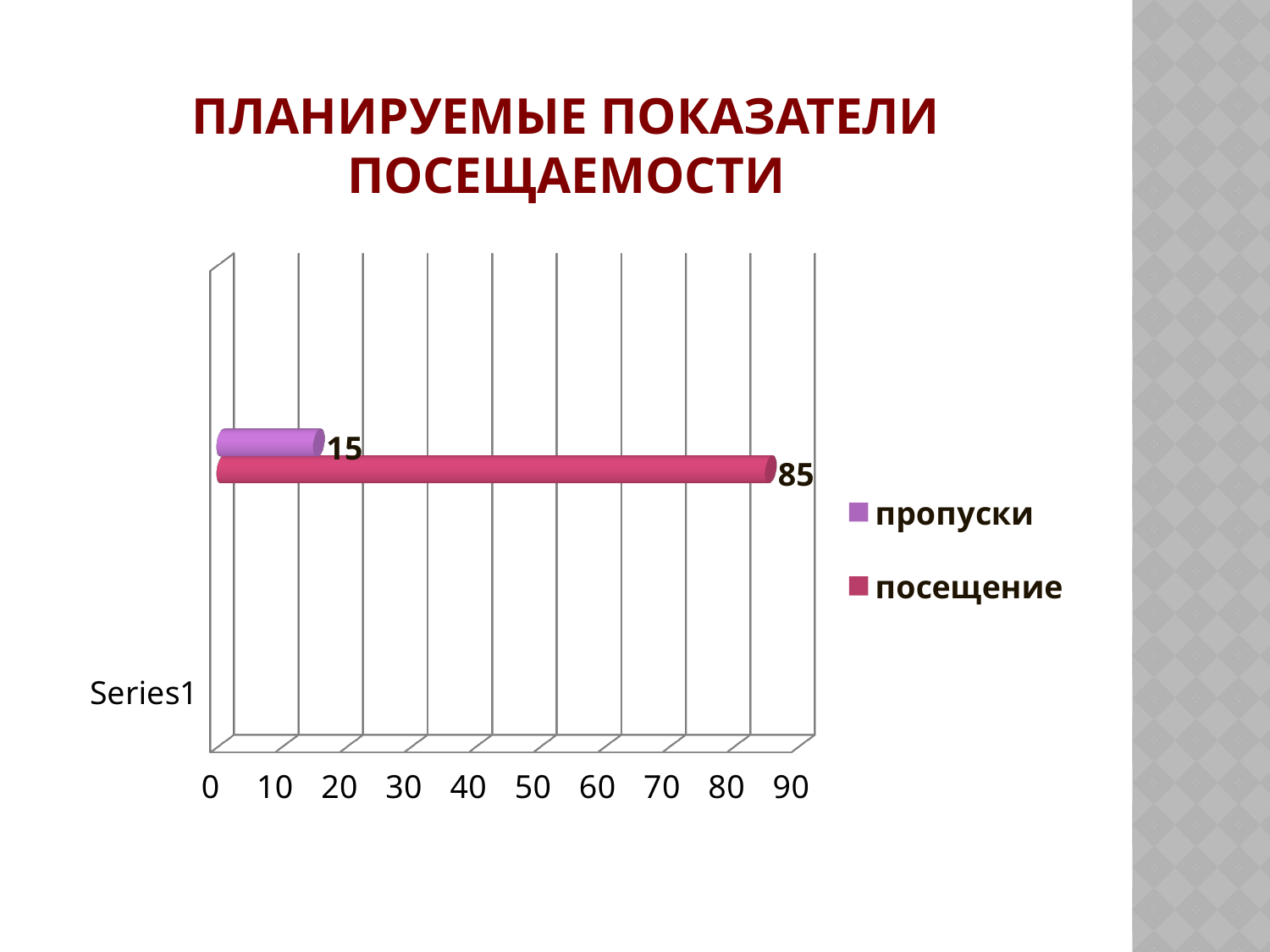
What is the category label shown on the vertical axis? Series1 What is the value for посещение? 85 What is the value for пропуски? 15 Which series has the higher value, пропуски or посещение? посещение What is the title of the slide? ПЛАНИРУЕМЫЕ ПОКАЗАТЕЛИ ПОСЕЩАЕМОСТИ What is the difference between the values for посещение and пропуски? 70 How many series does the legend list? 2 Is the value for посещение greater or less than 80? greater What is the highest value shown on the horizontal axis? 90 What kind of chart is shown on the slide? bar chart Which series has the lowest value? пропуски Is the value for пропуски greater or less than 20? less